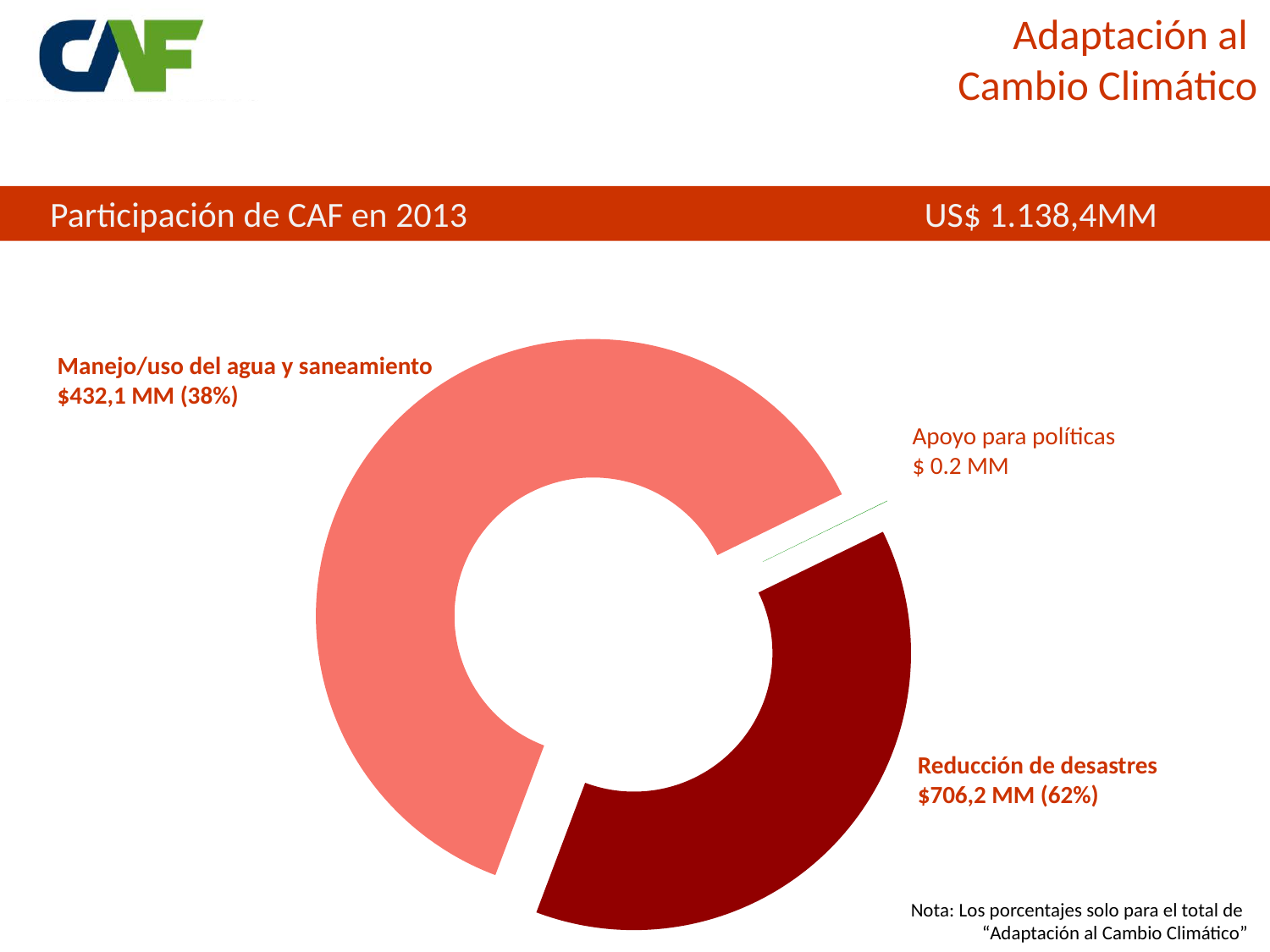
What kind of chart is shown on the slide? Doughnut chart What colour is the Reducción de desastres slice? Dark red What is the value for Reducción de desastres? $706,2 MM Which category has the largest slice? Reducción de desastres How many categories does the chart show? 3 What share of the chart does Manejo/uso del agua y saneamiento represent? 38% What is the value for Apoyo para políticas? $ 0.2 MM What is the difference between the values for Reducción de desastres and Manejo/uso del agua y saneamiento? $274,1 MM Which is larger, the value for Manejo/uso del agua y saneamiento or the value for Reducción de desastres? Reducción de desastres What is the value for Manejo/uso del agua y saneamiento? $432,1 MM What share of the chart does Reducción de desastres represent? 62% Which category has the smallest slice? Apoyo para políticas